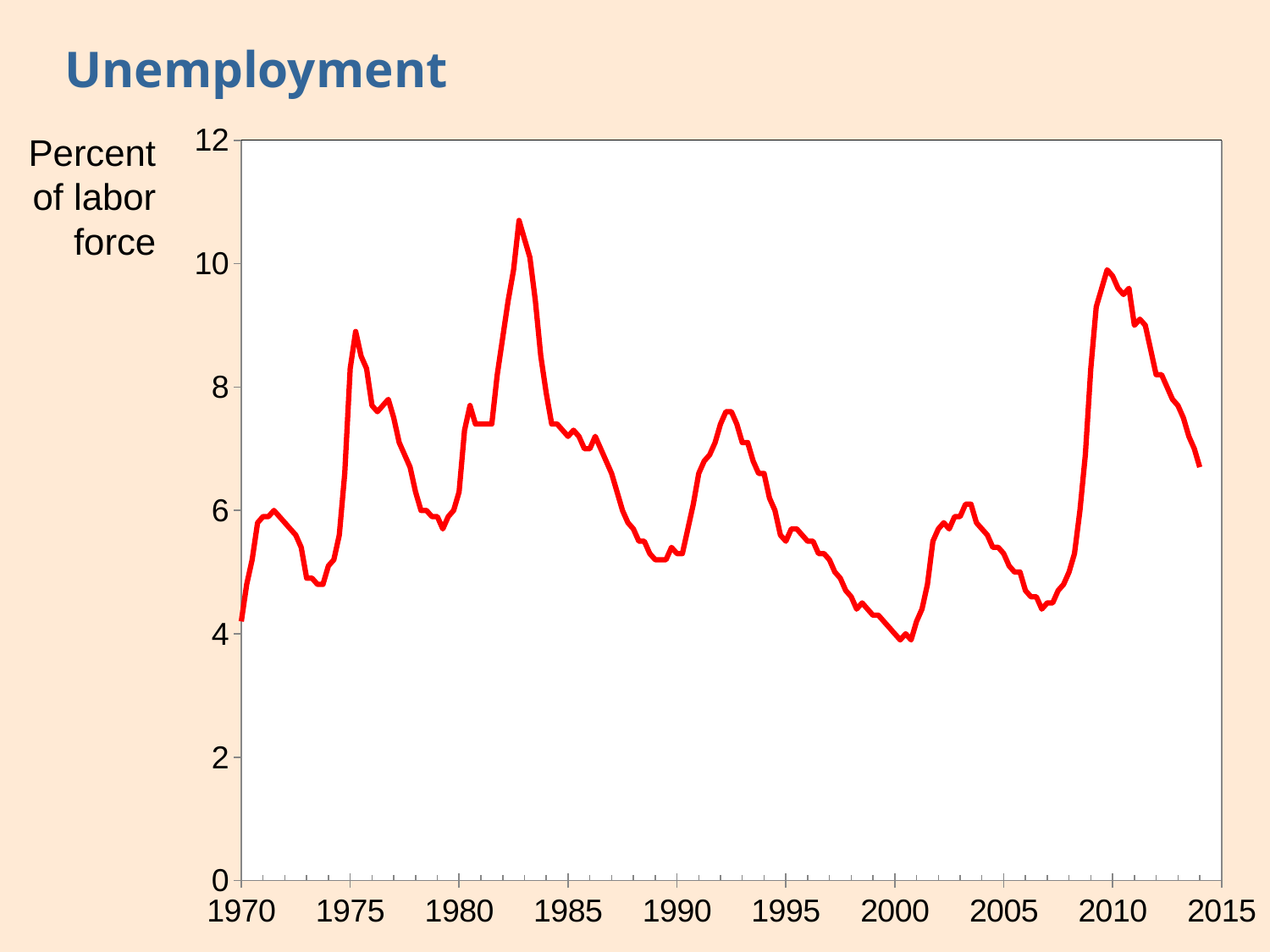
Does the unemployment rate rise or fall between 2010 and 2014? fall Does the unemployment rate rise or fall between 2007 and 2010? rise What kind of chart is shown on the slide? line chart Is the unemployment value in 1970 greater or less than 6? less Is the unemployment value in 2000 greater or less than 6? less Is the unemployment value in 2005 greater or less than 6? less What is the title of the chart? Unemployment Which is higher: the peak in unemployment around 1983 or the peak around 2010? the peak around 1983 What does the vertical axis of the chart measure, according to its label? Percent of labor force